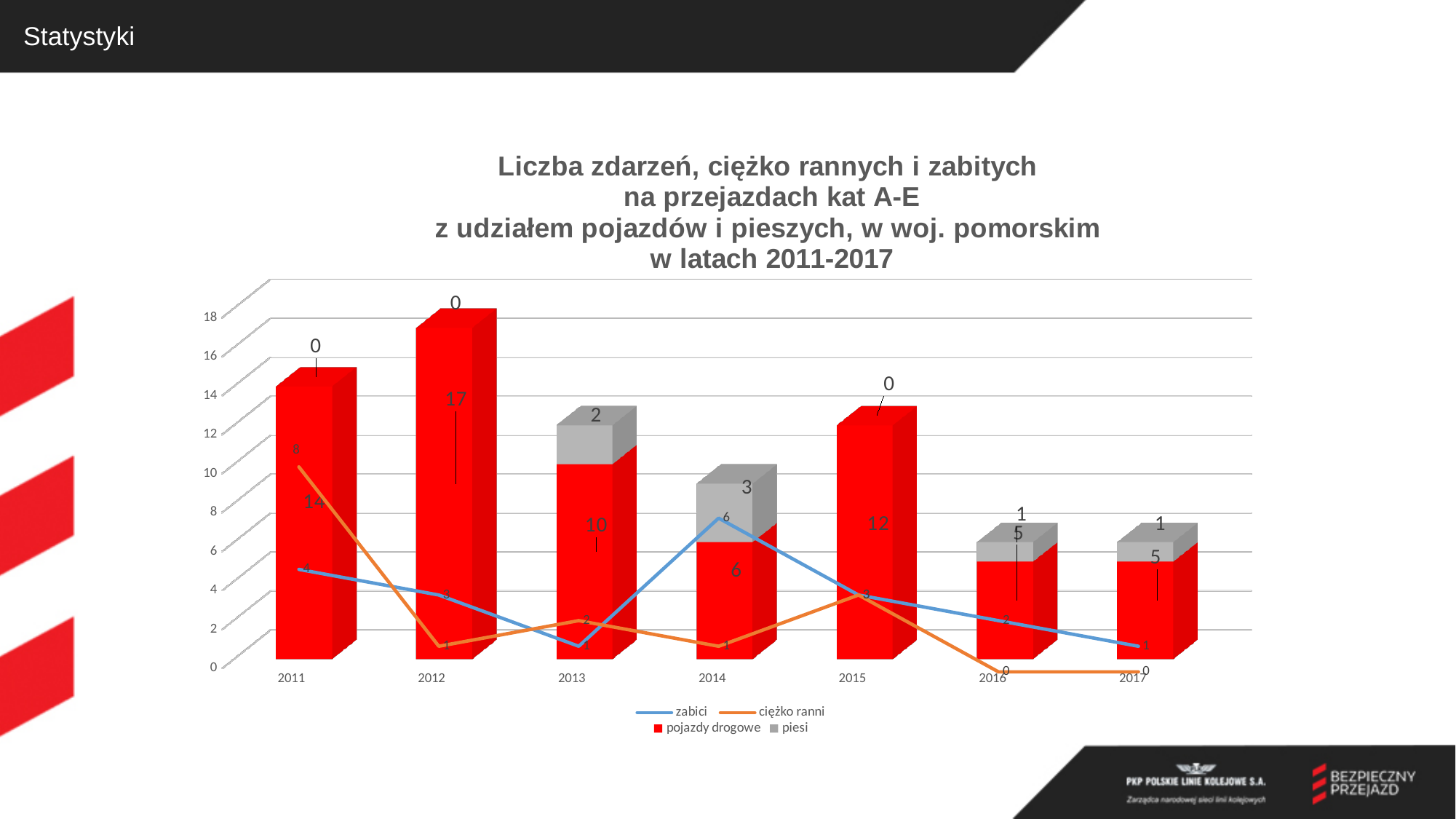
How many years are shown on the x axis? 7 Which year has the highest value for piesi? 2014 Which year has the highest value for pojazdy drogowe? 2012 Which is larger, the zabici value for 2011 or for 2015? 2011 What is the value for pojazdy drogowe in 2012? 17 What is the value for piesi in 2014? 3 How many series does the legend list? 4 What is the difference between the pojazdy drogowe values for 2012 and 2013? 7 What kind of chart is this? Combined bar and line chart What is the value for zabici in 2014? 6 What is the value for ciężko ranni in 2011? 8 What is the total of the stacked bar for 2013? 12